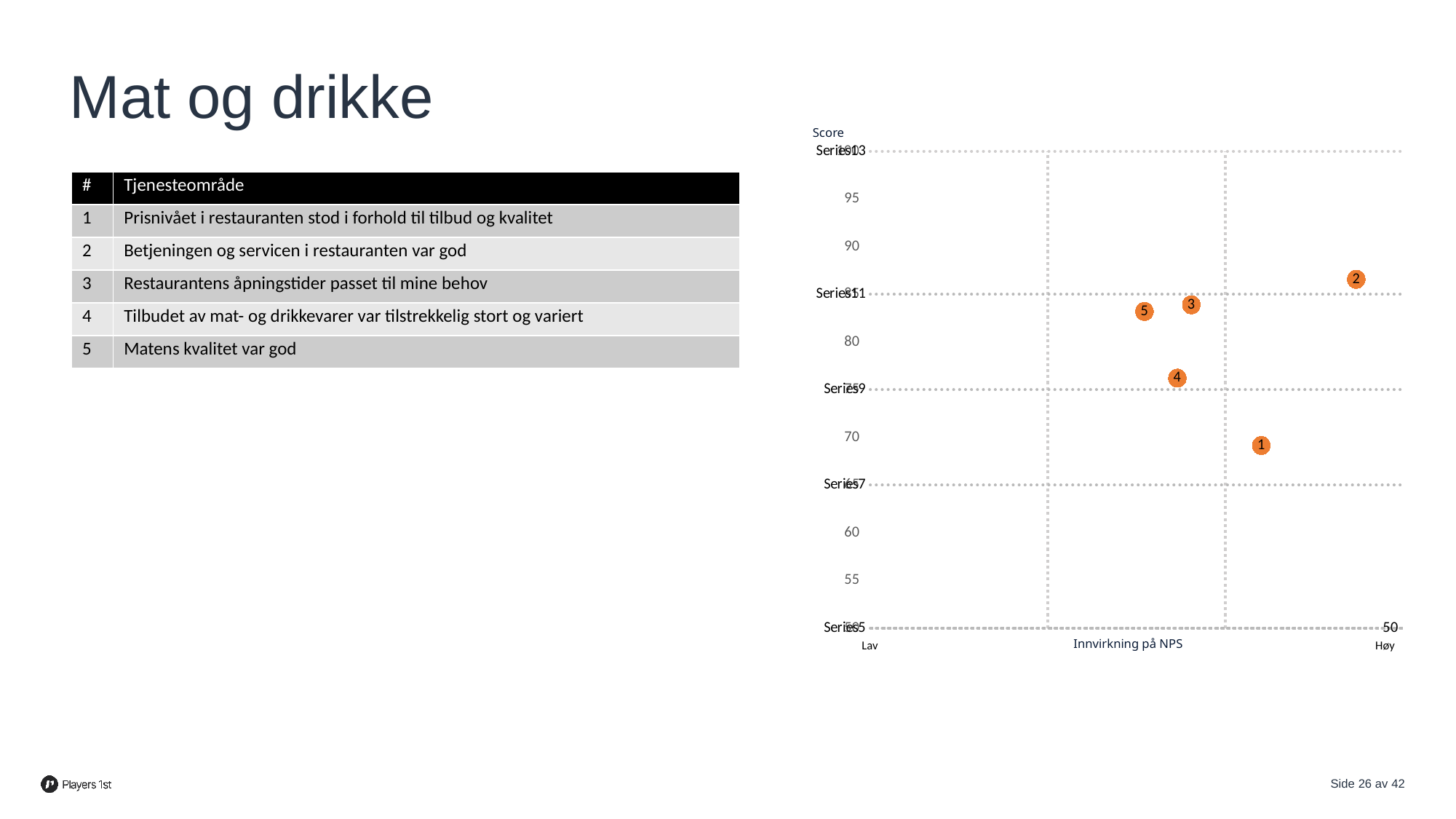
Which has the higher Score, point 4 or point 5? 5 Is the Score for point 1 greater or less than 75? less Which numbered point is furthest to the right on the 'Innvirkning på NPS' axis? 2 Which numbered point has the highest Score in the chart? 2 Is the Score for point 2 greater or less than 85? greater Is the Score for point 4 greater or less than 80? less What kind of chart is shown on the right of the slide? scatter chart How many data points are plotted in the chart? 5 What is the title of the vertical axis of the chart? Score What is the title of the horizontal axis of the chart? Innvirkning på NPS Which numbered point has the lowest Score in the chart? 1